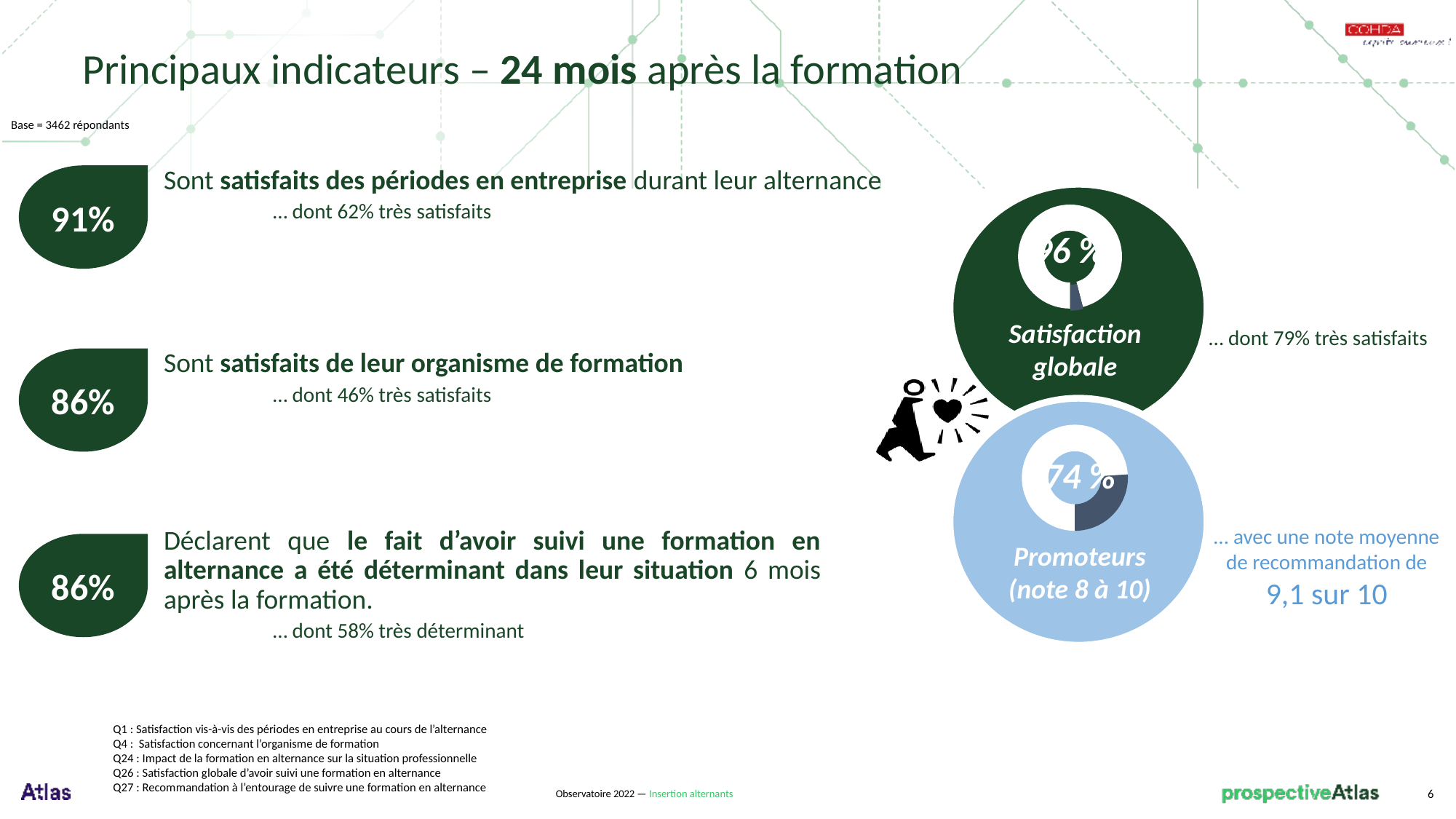
In the 'Promoteurs (note 8 à 10)' chart, is the highlighted value greater or less than 50%? greater Which of the two doughnut charts shows the larger value, 'Satisfaction globale' or 'Promoteurs (note 8 à 10)'? Satisfaction globale What kind of chart is used for 'Satisfaction globale' and 'Promoteurs (note 8 à 10)'? Doughnut chart What is the difference between the value in the 'Satisfaction globale' chart and the value in the 'Promoteurs (note 8 à 10)' chart? 22 percentage points How many doughnut charts are shown on the slide? 2 In the 'Promoteurs (note 8 à 10)' doughnut chart, what percentage is shown? 74 % What is the background colour of the circle containing the 'Satisfaction globale' chart? Dark green In the 'Promoteurs (note 8 à 10)' chart, what share of the ring is not covered by the 74 % segment? 26 % In the 'Satisfaction globale' doughnut chart, what percentage is shown? 96 % What is the background colour of the circle containing the 'Promoteurs (note 8 à 10)' chart? Light blue In the 'Satisfaction globale' chart, is the highlighted value greater or less than 90%? greater In the 'Satisfaction globale' chart, what share of the ring does the filled segment represent? 96 %